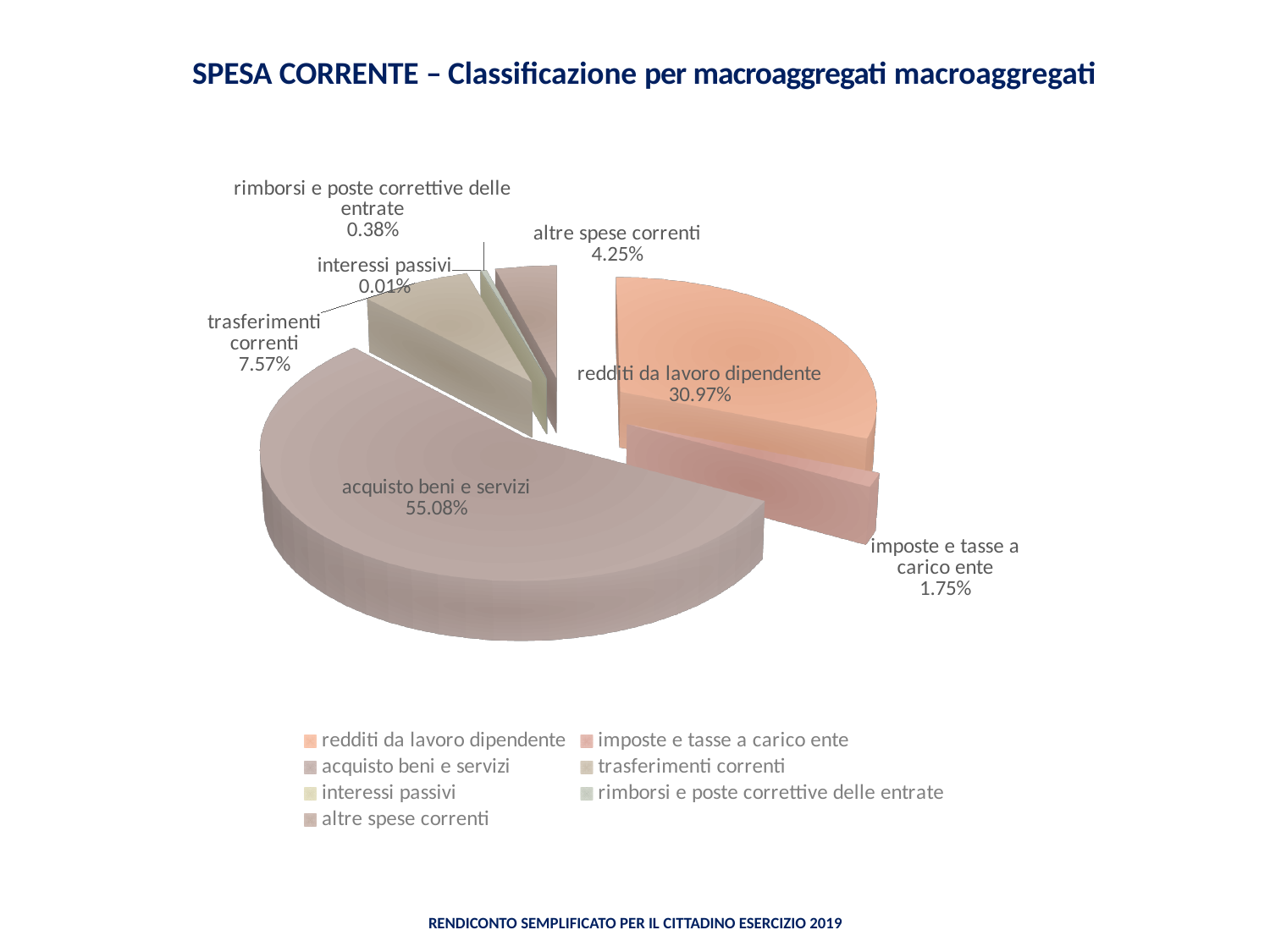
What kind of chart is shown on the slide? pie chart Which category has the largest share of the pie? acquisto beni e servizi What is the difference between the shares of 'acquisto beni e servizi' and 'redditi da lavoro dipendente'? 24.11% What is the value shown for 'trasferimenti correnti'? 7.57% How many categories does the pie chart show? 7 What is the value shown for 'altre spese correnti'? 4.25% What is the value shown for 'rimborsi e poste correttive delle entrate'? 0.38% Which is larger, 'trasferimenti correnti' or 'altre spese correnti'? trasferimenti correnti What is the value shown for 'redditi da lavoro dipendente'? 30.97% What share of the pie does 'acquisto beni e servizi' represent? 55.08% Which category has the smallest share of the pie? interessi passivi What is the value shown for 'imposte e tasse a carico ente'? 1.75%